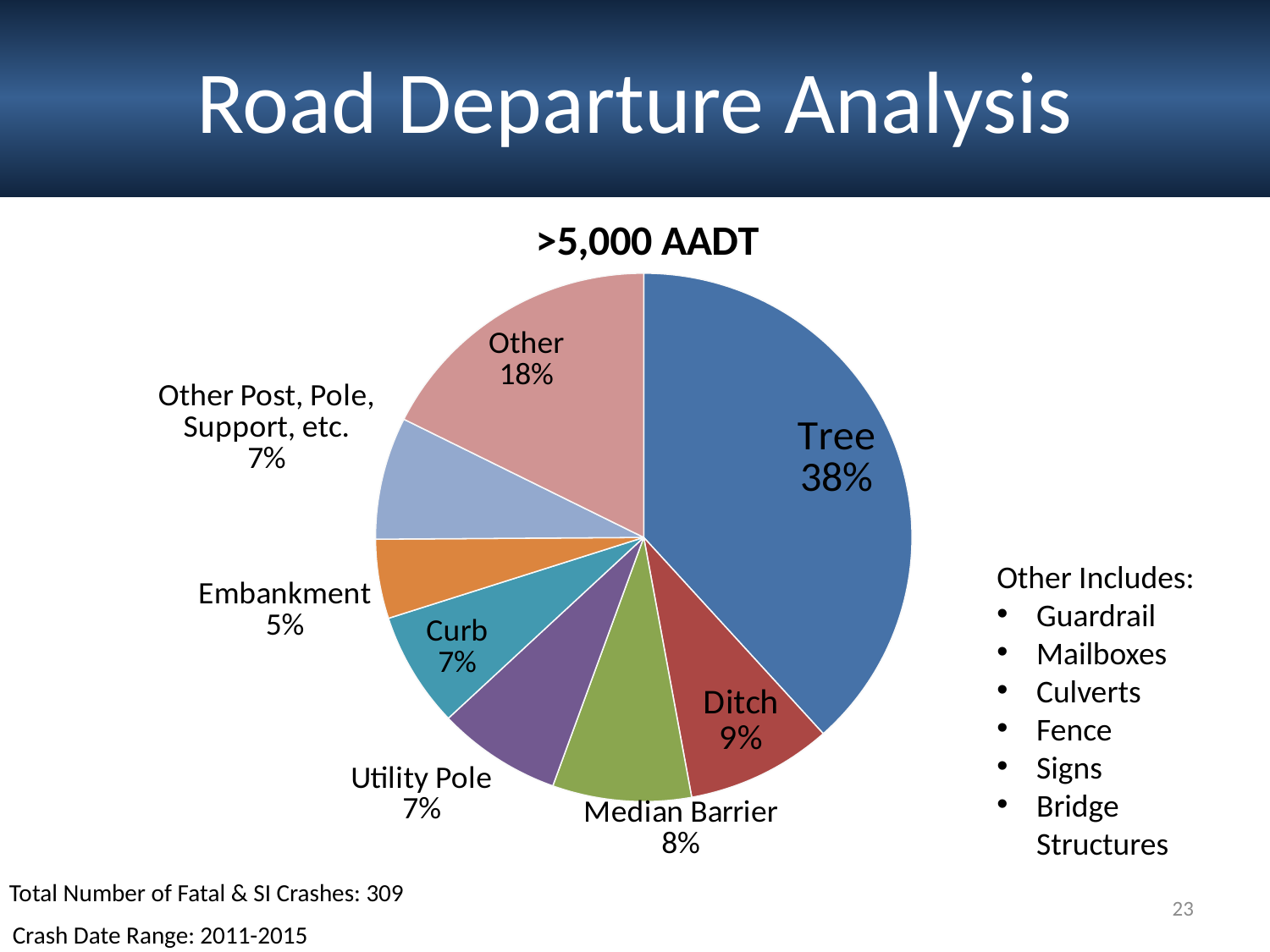
What is the difference in percentage points between Tree and Other? 20 What percentage is shown for Median Barrier? 8% Which is larger, the share for Ditch or the share for Median Barrier? Ditch What share of the pie does Tree account for? 38% What type of chart is shown on the slide? Pie chart What percentage is shown for Ditch? 9% Which category has the smallest slice of the pie? Embankment Which category has the largest slice of the pie? Tree What percentage is shown for Embankment? 5% What percentage is shown for Other? 18% How many slices does the pie chart have? 8 What is the title of the chart? >5,000 AADT